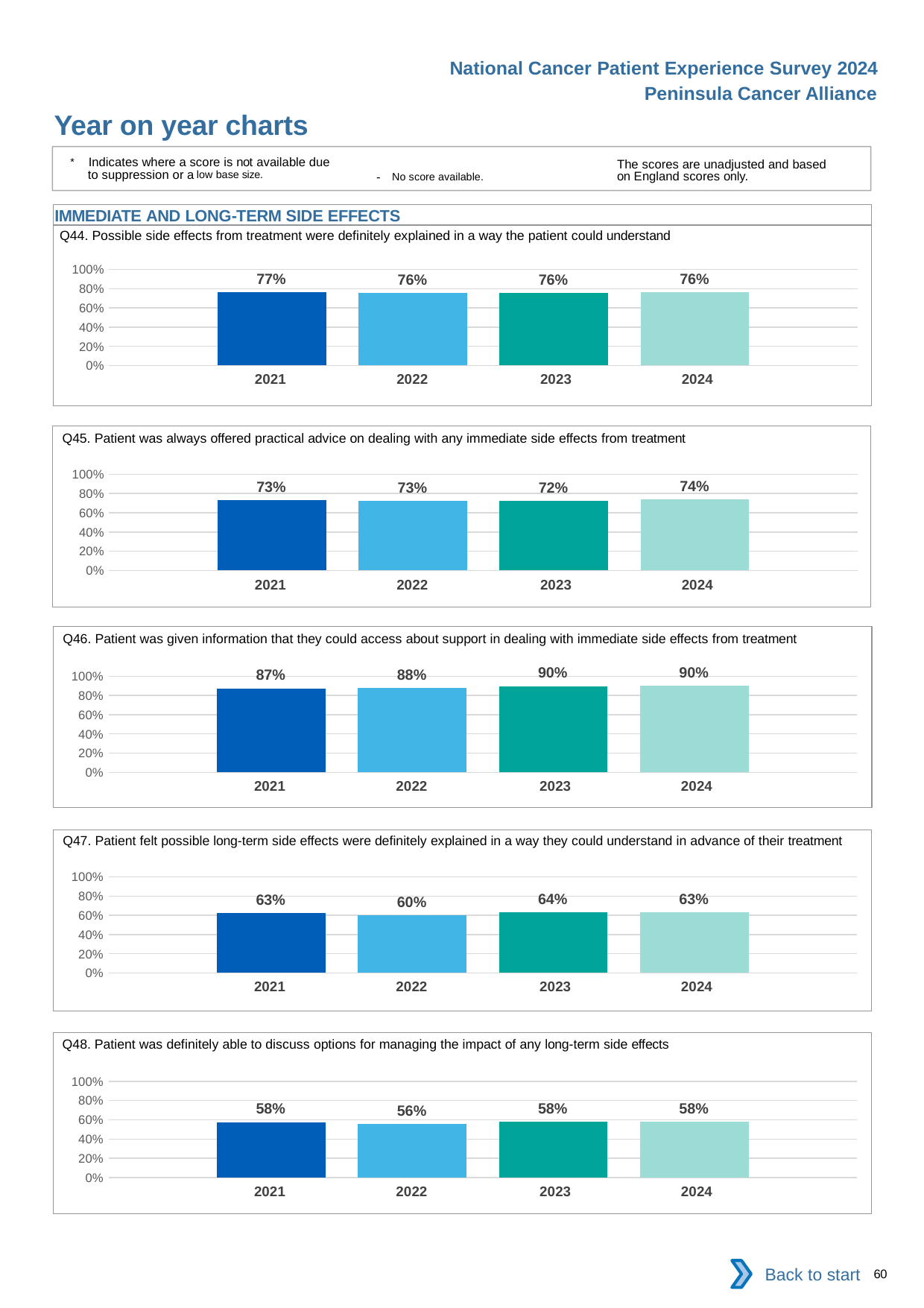
In the Q48 chart, what is the value for 2022? 56% What kind of chart is the Q45 chart? bar chart In the Q45 chart, what is the difference between the 2024 value and the 2023 value? 2% In the Q44 chart, what is the value for 2021? 77% In the Q46 chart, do the values generally rise or fall from 2021 to 2024? rise In the Q47 chart, which year has the lowest value? 2022 In the Q46 chart, what is the difference between the 2024 value and the 2021 value? 3% In the Q46 chart, is the value for 2023 greater or less than 80%? greater In the Q45 chart, which year has the highest value? 2024 How many years are shown on the x axis of the Q44 chart? 4 In the Q47 chart, is the value for 2023 larger or smaller than the value for 2022? larger How many charts are shown on the slide? 5